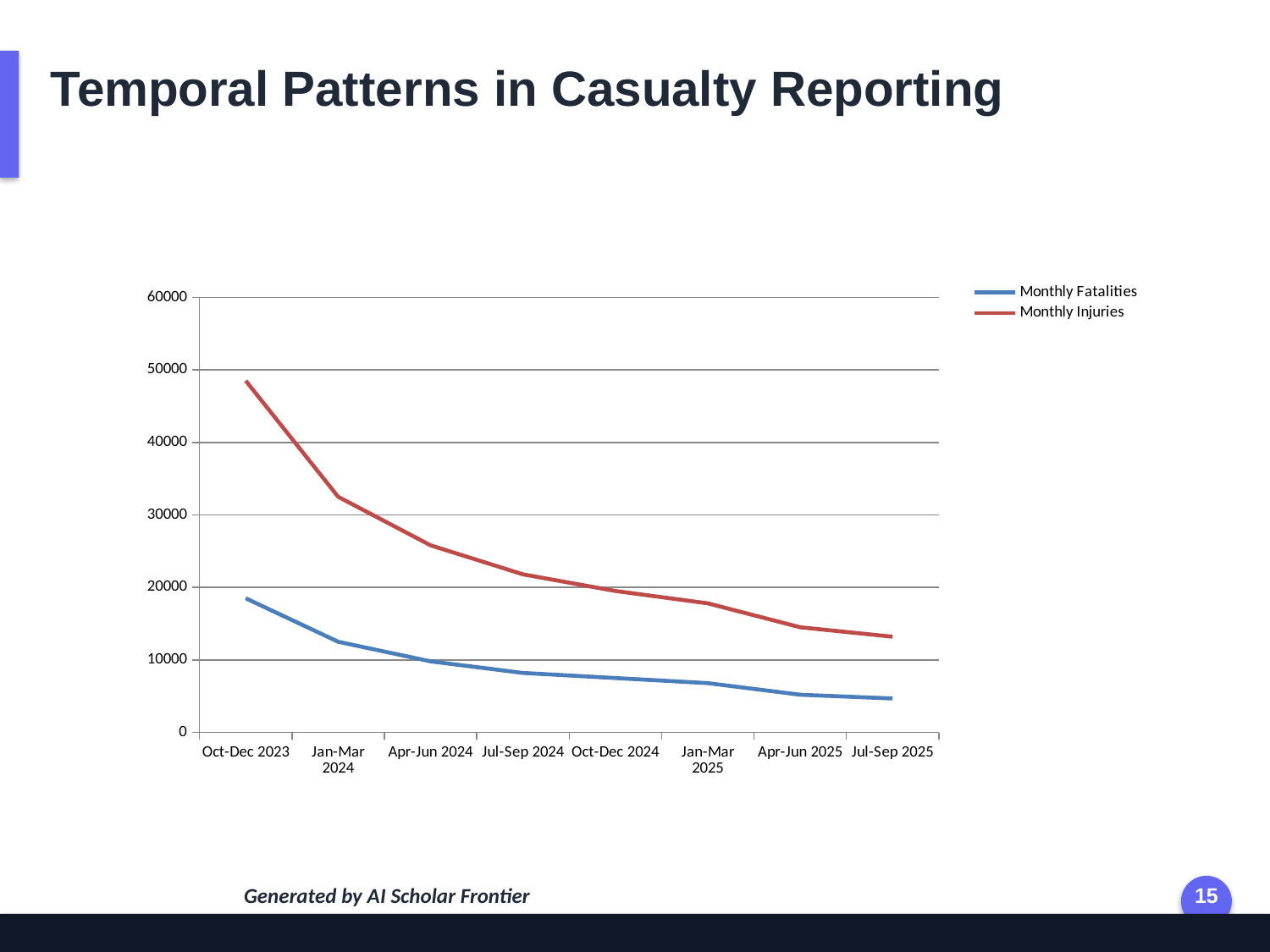
In which period are Monthly Injuries highest? Oct-Dec 2023 How many time periods are shown on the x axis? 8 In which period are Monthly Fatalities lowest? Jul-Sep 2025 Do the Monthly Injuries values rise or fall from Oct-Dec 2023 to Jul-Sep 2025? fall Is the Monthly Injuries value for Oct-Dec 2023 greater or less than 40000? greater What kind of chart is shown on the slide? line chart Which series is shown in red? Monthly Injuries How many series does the legend list? 2 Which is larger in Jan-Mar 2025, Monthly Injuries or Monthly Fatalities? Monthly Injuries Do the Monthly Fatalities values rise or fall across the periods shown? fall Is the Monthly Fatalities value for Jul-Sep 2025 greater or less than 10000? less What is the title of the slide containing the chart? Temporal Patterns in Casualty Reporting